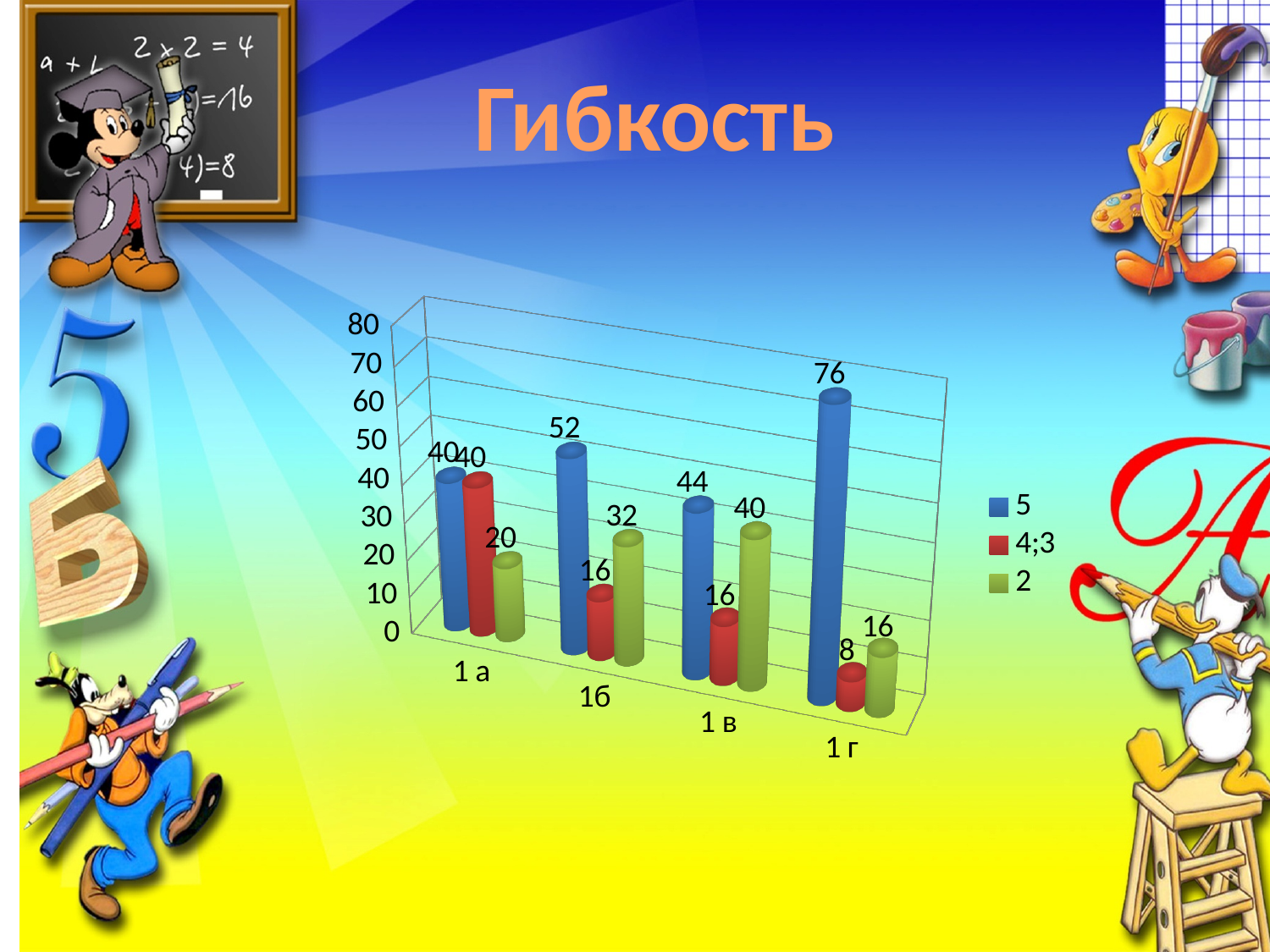
What is the value of series "4;3" for category "1б"? 16 How many categories are shown on the x axis? 4 Which is larger: the series "2" value for "1б" or for "1 в"? 1 в How many series does the legend list? 3 What is the difference between the series "5" values for "1 г" and "1б"? 24 What colour are the bars for series "4;3"? red Which category has the lowest value for series "4;3"? 1 г What is the value of series "5" for category "1 г"? 76 What is the value of series "2" for category "1 в"? 40 What is the title of the slide above the chart? Гибкость What kind of chart is shown on the slide? bar chart Which category has the highest value for series "5"? 1 г